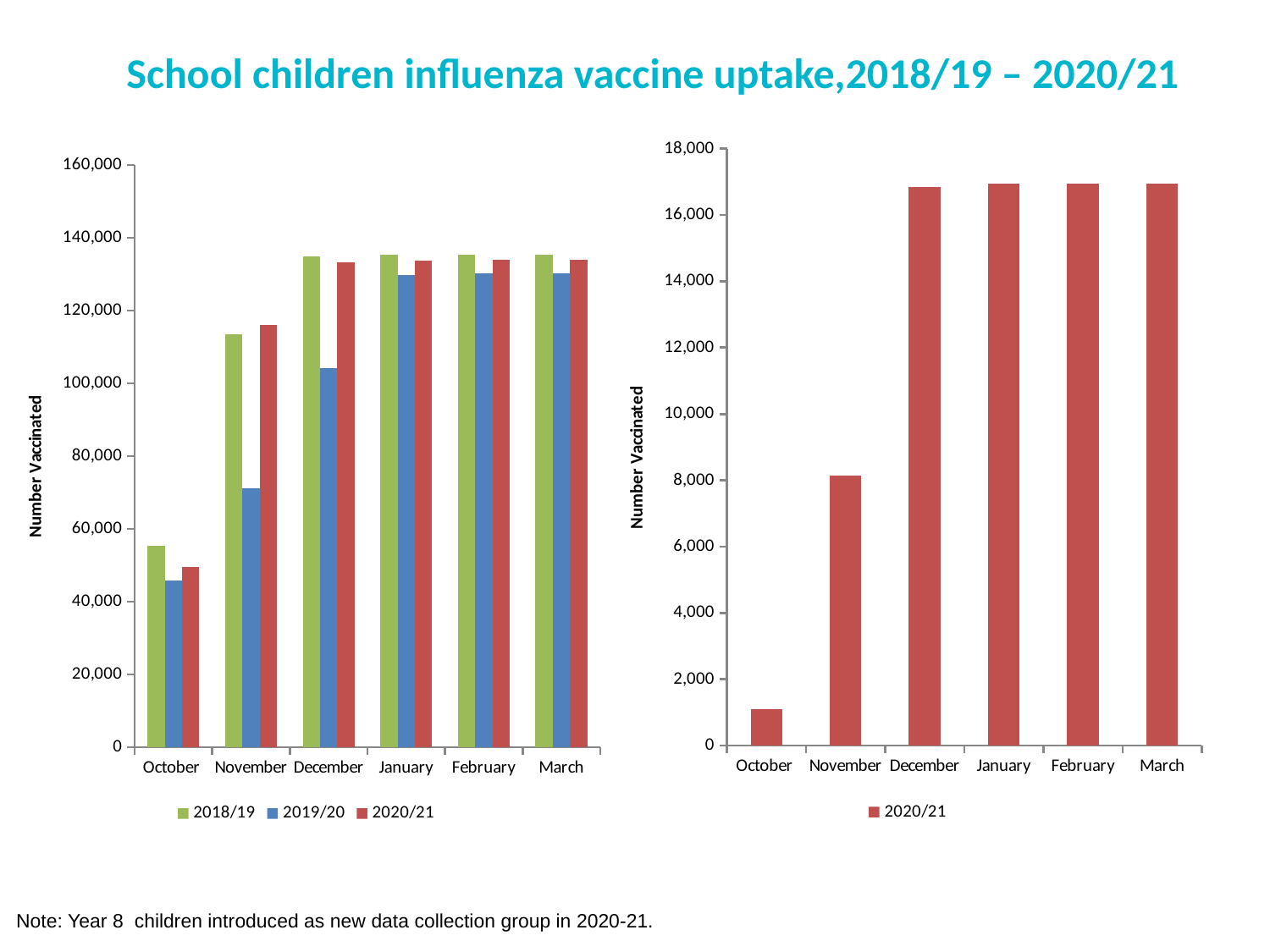
In the right chart, is the value for October greater or less than 2,000? less In the left chart, is the value for 2019/20 in December greater or less than 100,000? greater In the left chart, which is larger in November: the 2018/19 value or the 2019/20 value? 2018/19 In the right chart, which month has the lowest value? October What kind of chart is the left chart on the slide? bar chart In the right chart, do the values rise or fall from October to December? rise How many months are shown on the x axis of the right chart? 6 In the left chart, is the value for 2019/20 in October greater or less than 60,000? less In the left chart, which month has the lowest value for the 2018/19 series? October How many series does the legend of the left chart list? 3 What is the y-axis label of the right chart? Number Vaccinated